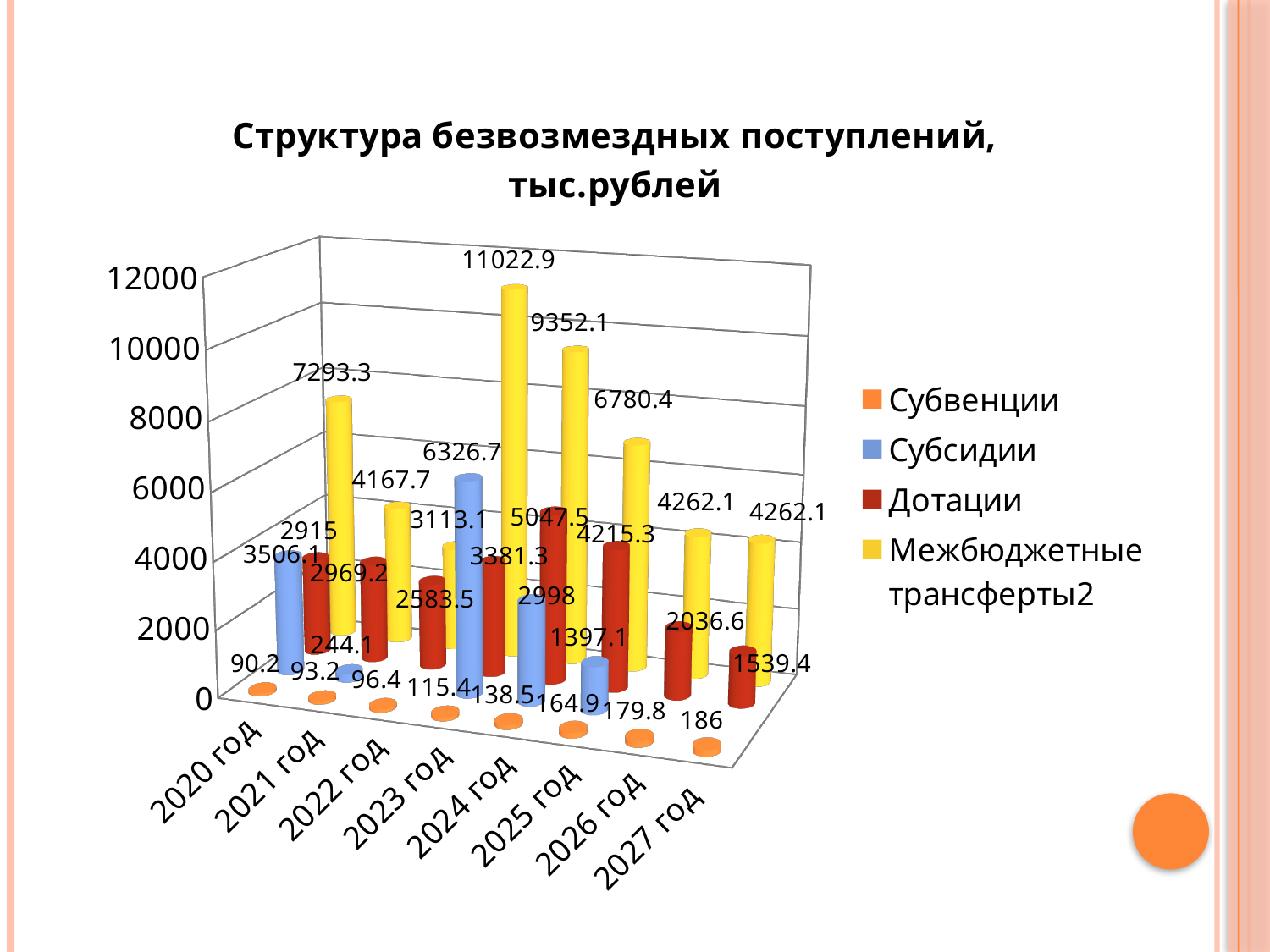
What is the value of Субвенции for 2027 год? 186 Do the values for Субвенции rise or fall from 2020 год to 2027 год? rise What is the value of Субвенции for 2020 год? 90.2 Which year has the highest value for Межбюджетные трансферты2? 2023 год Which is larger: Межбюджетные трансферты2 in 2023 год or in 2024 год? 2023 год Which year has the lowest value for Субвенции? 2020 год What is the difference between the Субвенции values for 2027 год and 2020 год? 95.8 How many series does the legend list? 4 What kind of chart is shown on the slide? bar chart How many years are shown on the x axis? 8 Is the value for Межбюджетные трансферты2 in 2023 год greater or less than 10000? greater What colour represents Субвенции in the legend? orange